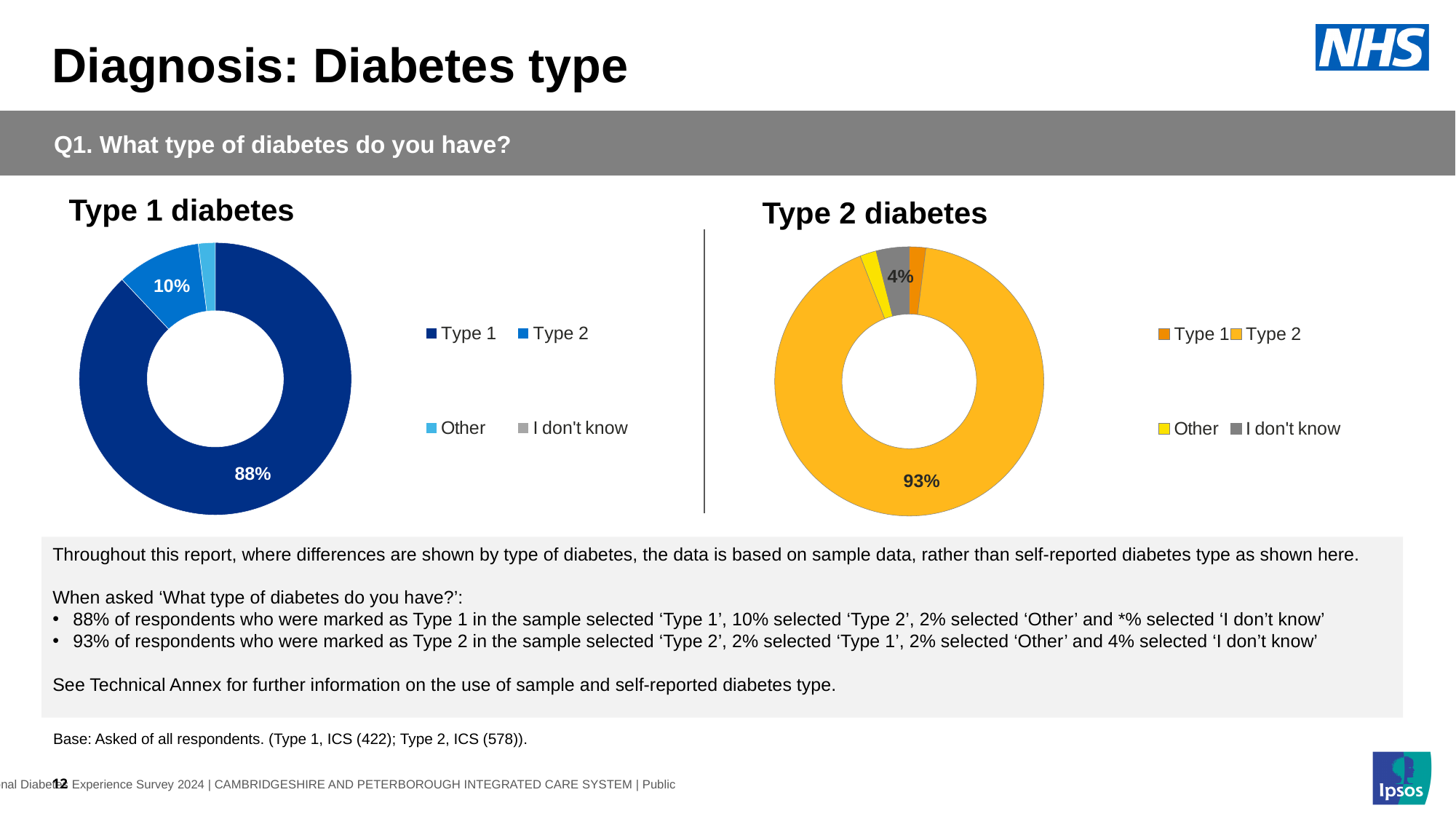
In the Type 1 diabetes chart, which is larger: the 'Type 1' share or the 'Type 2' share? Type 1 In the Type 2 diabetes chart, what is the difference between the 'Type 2' and 'I don't know' shares? 89 percentage points In the Type 2 diabetes chart, what percentage selected 'I don't know'? 4% What kind of chart is used for the Type 2 diabetes data? Donut (pie) chart Which of the two charts uses blue colours for its slices? Type 1 diabetes In the Type 2 diabetes chart, what percentage selected 'Type 2'? 93% In the Type 1 diabetes chart, what percentage selected 'Type 2'? 10% In the Type 2 diabetes chart, which category has the largest slice? Type 2 In the Type 1 diabetes chart, what percentage selected 'Type 1'? 88% How many categories does the legend of the Type 1 diabetes chart list? 4 In the Type 1 diabetes chart, which category has the largest slice? Type 1 In the Type 1 diabetes chart, what is the difference between the 'Type 1' and 'Type 2' shares? 78 percentage points